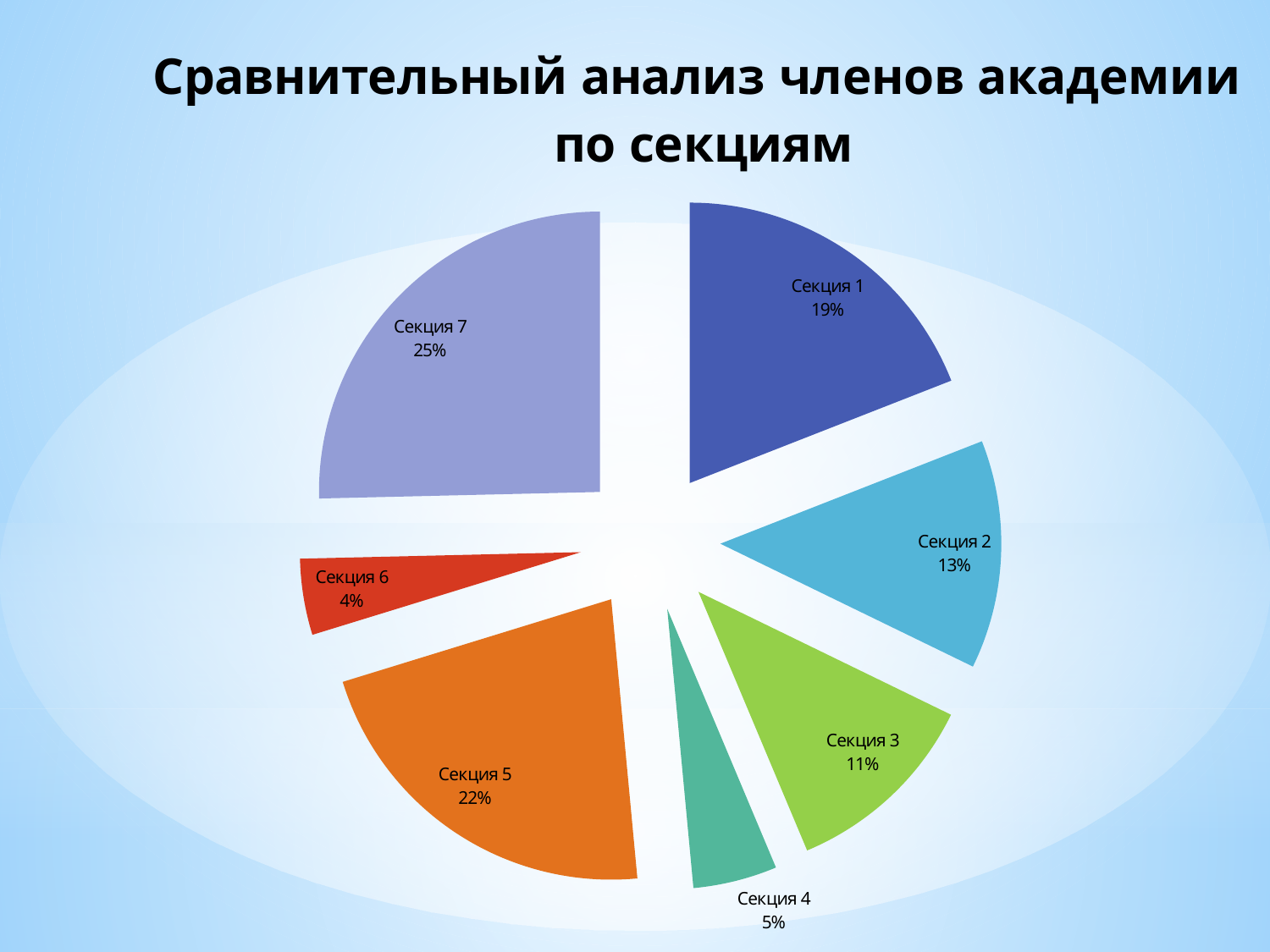
What is the difference between the shares of Секция 5 and Секция 6? 18% Which is larger, the share of Секция 2 or Секция 3? Секция 2 Which section has the smallest share? Секция 6 What share does Секция 5 have? 22% What is the difference between the shares of Секция 7 and Секция 1? 6% What is the title of the slide? Сравнительный анализ членов академии по секциям Which section has the largest share? Секция 7 What kind of chart is shown on the slide? pie chart What share does Секция 4 have? 5% What colour is the slice for Секция 5? orange What share does Секция 1 have? 19% How many sections are shown in the pie chart? 7